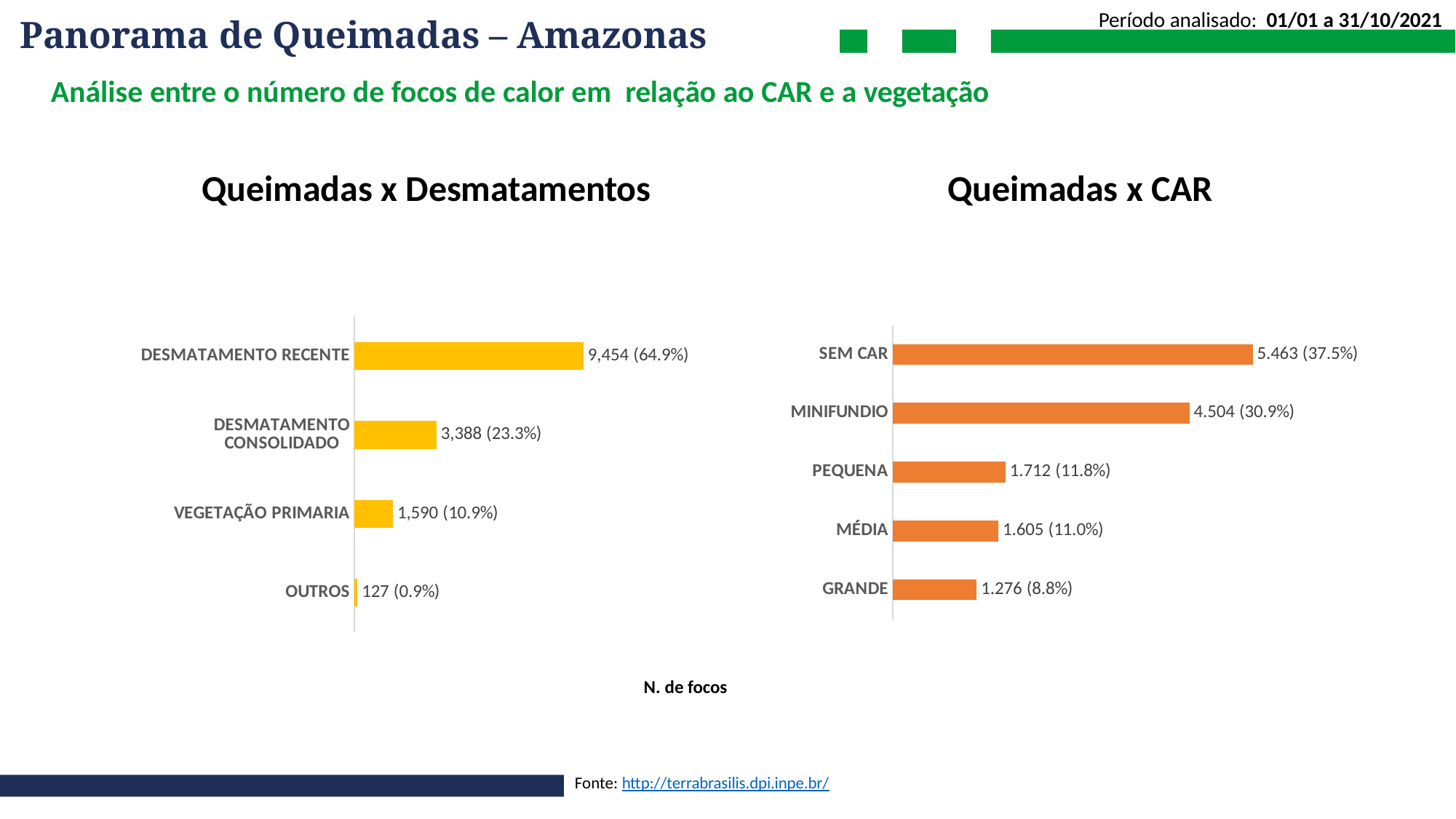
What kind of chart is 'Queimadas x CAR'? Bar chart In the 'Queimadas x CAR' chart, what is the value for MINIFUNDIO? 4.504 (30.9%) In the 'Queimadas x CAR' chart, what is the value for GRANDE? 1.276 (8.8%) In the 'Queimadas x Desmatamentos' chart, what is the difference in number of focos between DESMATAMENTO RECENTE and DESMATAMENTO CONSOLIDADO? 6,066 In the 'Queimadas x CAR' chart, which category has the highest value? SEM CAR In the 'Queimadas x CAR' chart, how many categories are shown? 5 What colour are the bars in the 'Queimadas x Desmatamentos' chart? Yellow In the 'Queimadas x CAR' chart, which is larger, the value for PEQUENA or the value for GRANDE? PEQUENA In the 'Queimadas x Desmatamentos' chart, which category has the lowest value? OUTROS In the 'Queimadas x Desmatamentos' chart, how many categories are shown? 4 In the 'Queimadas x Desmatamentos' chart, what is the value for VEGETAÇÃO PRIMARIA? 1,590 (10.9%) In the 'Queimadas x Desmatamentos' chart, what is the value for DESMATAMENTO RECENTE? 9,454 (64.9%)